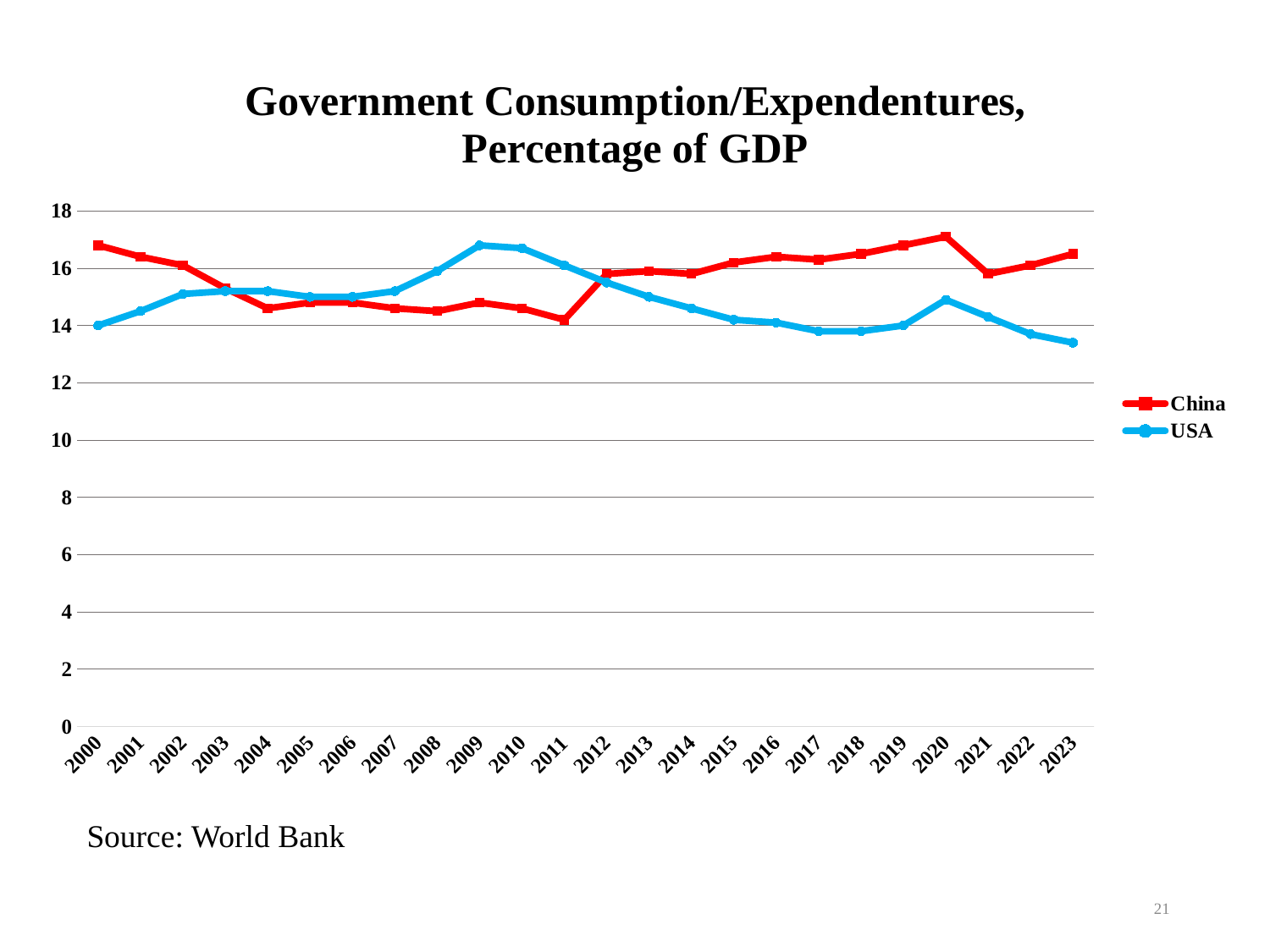
How many series does the legend list? 2 In which year does the China series reach its highest value? 2020 Is the value for USA in 2023 greater or less than 14? less In 2020, which series has the higher value, China or USA? China In 2009, which series has the higher value, China or USA? USA How many years are plotted along the x axis? 24 In which year does the USA series reach its lowest value? 2023 Is the value for China in 2020 greater or less than 16? greater Is the value for China in 2011 greater or less than 16? less Does the USA series rise or fall from 2009 to 2017? fall What kind of chart is shown on the slide? line chart